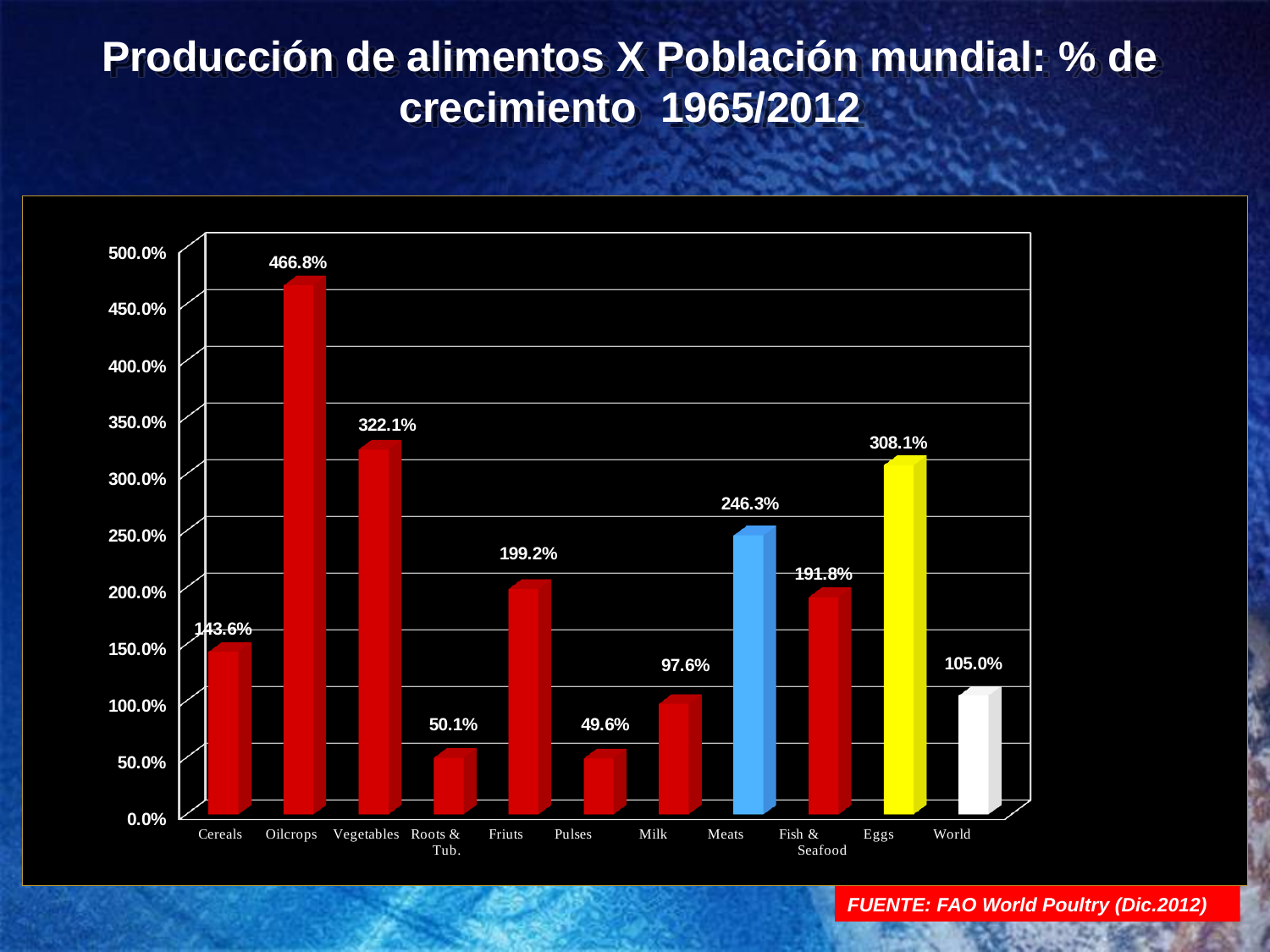
Which category has the highest value? Oilcrops What kind of chart is shown on the slide? Bar chart What is the value for Eggs? 308.1% Which category has the lowest value? Pulses What is the difference between the values for Oilcrops and Vegetables? 144.7% Which is larger, the value for Milk or the value for Fish & Seafood? Fish & Seafood How many categories are shown on the x axis? 11 What is the difference between the values for Eggs and Meats? 61.8% What is the value for Oilcrops? 466.8% What is the value for Meats? 246.3% What colour is the bar for Meats? Blue What is the value for World? 105.0%